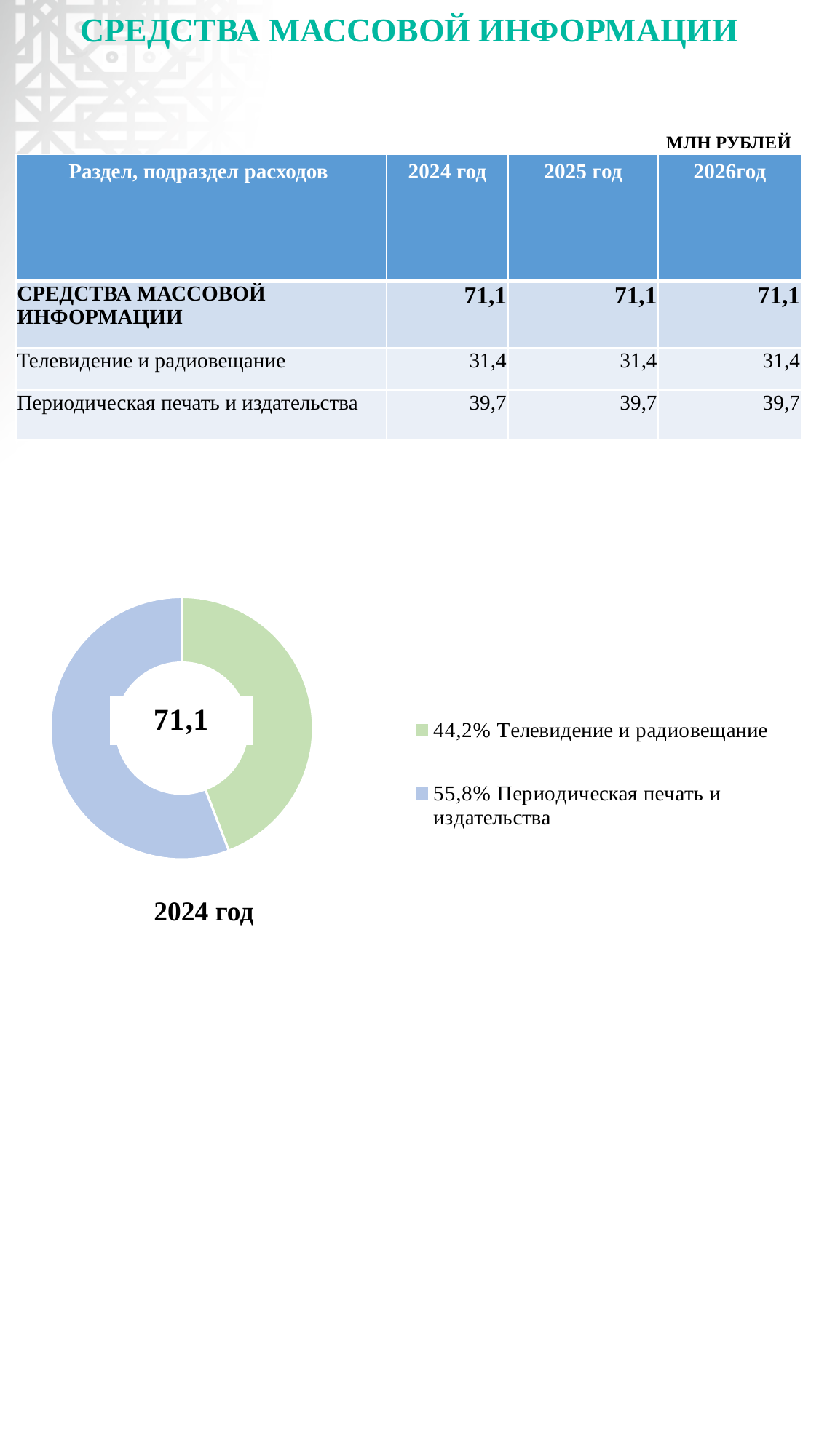
What colour is the Телевидение и радиовещание slice in the doughnut chart? Green What share of the doughnut chart does Телевидение и радиовещание represent? 44,2% Which year does the doughnut chart represent? 2024 год What kind of chart is shown on the slide? Doughnut (pie) chart Which slice of the doughnut chart is the largest? Периодическая печать и издательства What total value is shown in the centre of the doughnut chart? 71,1 How many slices does the doughnut chart have? 2 What share of the doughnut chart does Периодическая печать и издательства represent? 55,8% Is the share for Периодическая печать и издательства greater or less than 50%? greater Which slice of the doughnut chart is the smallest? Телевидение и радиовещание Which is larger in the doughnut chart: Телевидение и радиовещание or Периодическая печать и издательства? Периодическая печать и издательства What is the difference in percentage points between the two slices of the doughnut chart? 11,6